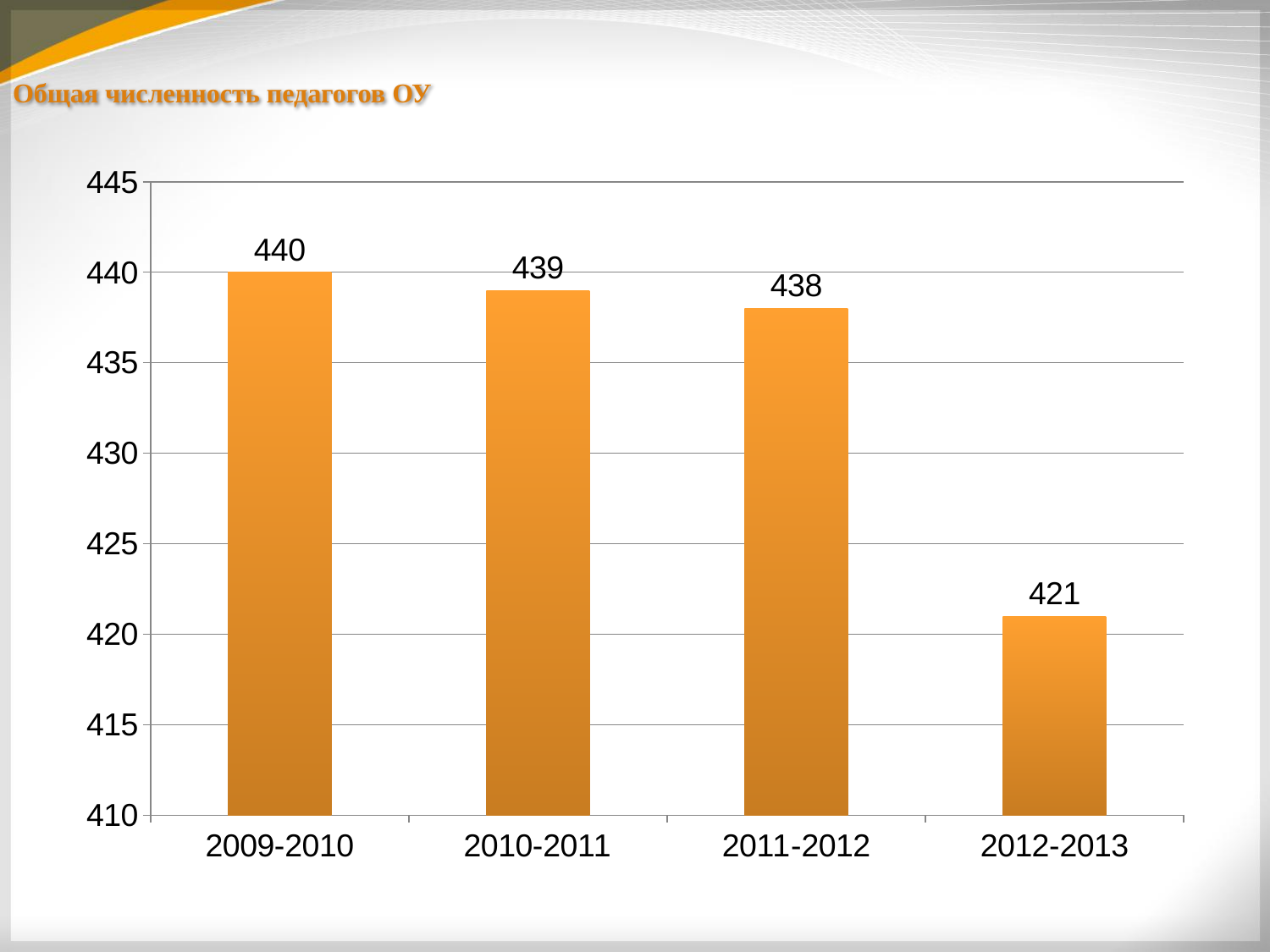
Which is larger, the value for 2010-2011 or the value for 2012-2013? 2010-2011 Do the values rise or fall from 2009-2010 to 2012-2013? fall What is the value for 2009-2010? 440 Is the value for 2012-2013 greater or less than 425? less Which period has the highest value? 2009-2010 What kind of chart is shown on the slide? bar chart What is the value for 2011-2012? 438 How many periods are shown on the x axis? 4 What is the difference between the values for 2009-2010 and 2010-2011? 1 What is the difference between the values for 2011-2012 and 2012-2013? 17 Which period has the lowest value? 2012-2013 What is the value for 2012-2013? 421